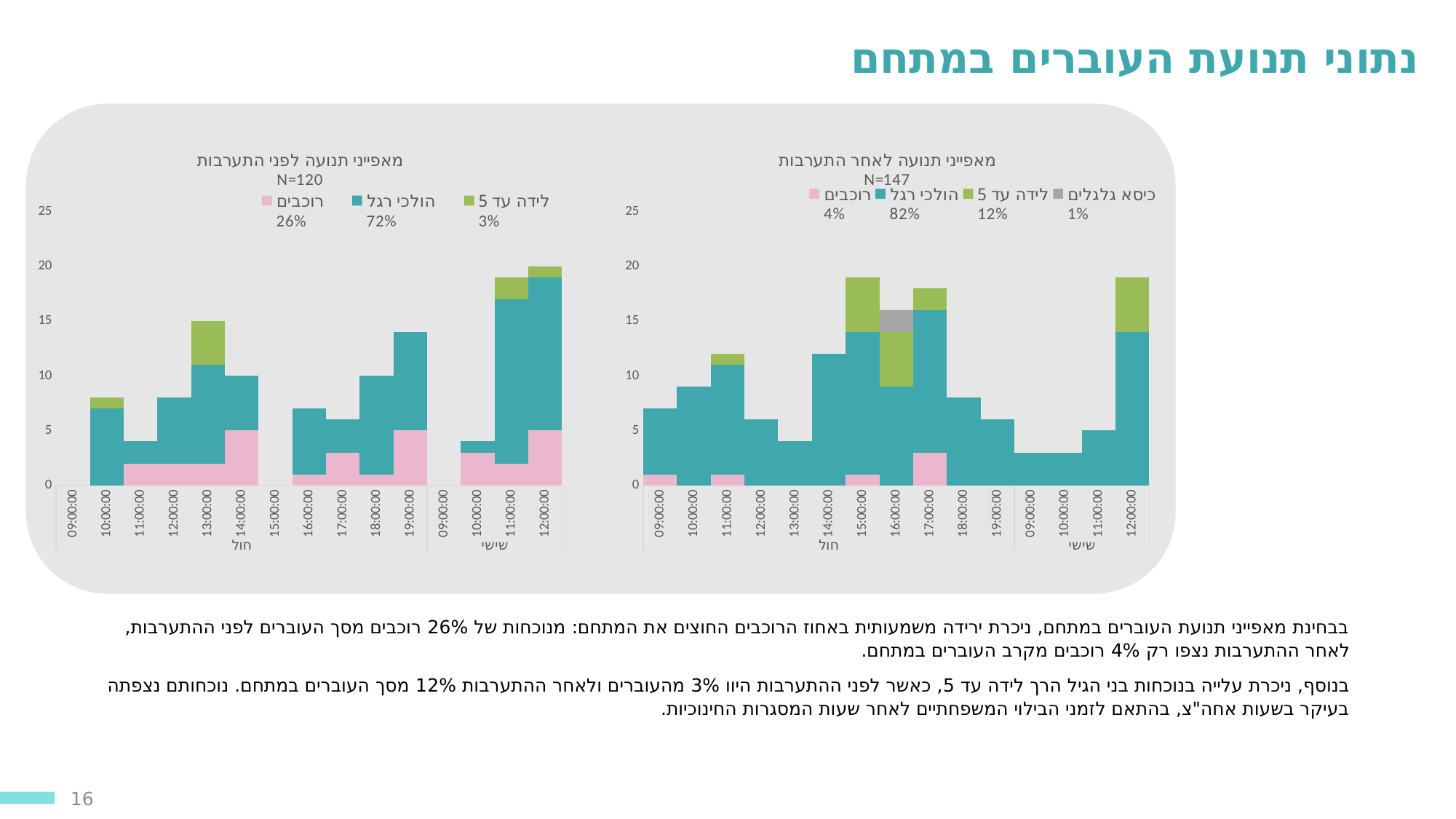
In the right chart (לאחר התערבות), what percentage is shown for רוכבים in the legend? 4% In the right chart (לאחר התערבות), how many series does the legend list? 4 In the left chart (לפני התערבות), how many series does the legend list? 3 What kind of chart is shown on the left side of the slide (מאפייני תנועה לפני התערבות)? Stacked bar chart In the left chart (לפני התערבות), is the total bar height for 11:00 on שישי greater or less than 15? greater In the right chart (לאחר התערבות), what percentage is shown for כיסא גלגלים in the legend? 1% By how many percentage points does the share of הולכי רגל in the right chart (82%) exceed the share in the left chart (72%)? 10 percentage points What is the sample size (N) stated under the title of the left chart (לפני התערבות)? N=120 In the left chart (לפני התערבות), what percentage is shown for הולכי רגל in the legend? 72% What is the sample size (N) stated under the title of the right chart (לאחר התערבות)? N=147 In the right chart (לאחר התערבות), is the total bar height for 09:00 on שישי greater or less than 5? less In the right chart (לאחר התערבות), which series has the largest percentage in the legend? הולכי רגל